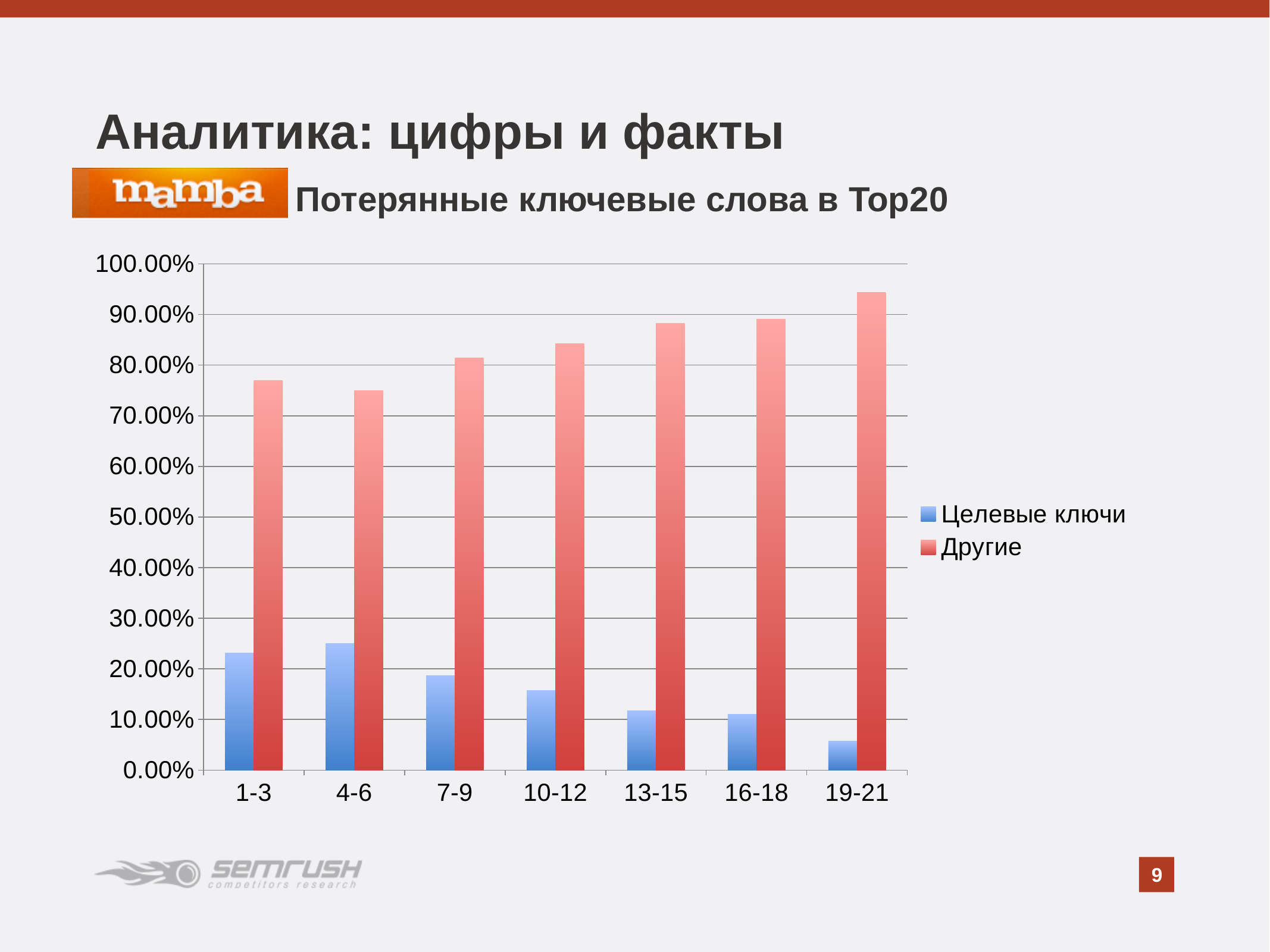
Is the value for Другие in category 19-21 greater or less than 90.00%? greater How many series does the legend list? 2 Which is larger in category 10-12: Целевые ключи or Другие? Другие What kind of chart is shown on the slide? bar chart Is the value for Целевые ключи in category 1-3 greater or less than 20.00%? greater Which category has the highest value for Другие? 19-21 Is the value for Другие in category 1-3 greater or less than 80.00%? less Which category has the lowest value for Целевые ключи? 19-21 How many categories are shown on the x axis? 7 Do the values for Другие generally rise or fall from 4-6 to 19-21 along the x axis? rise Which category has the highest value for Целевые ключи? 4-6